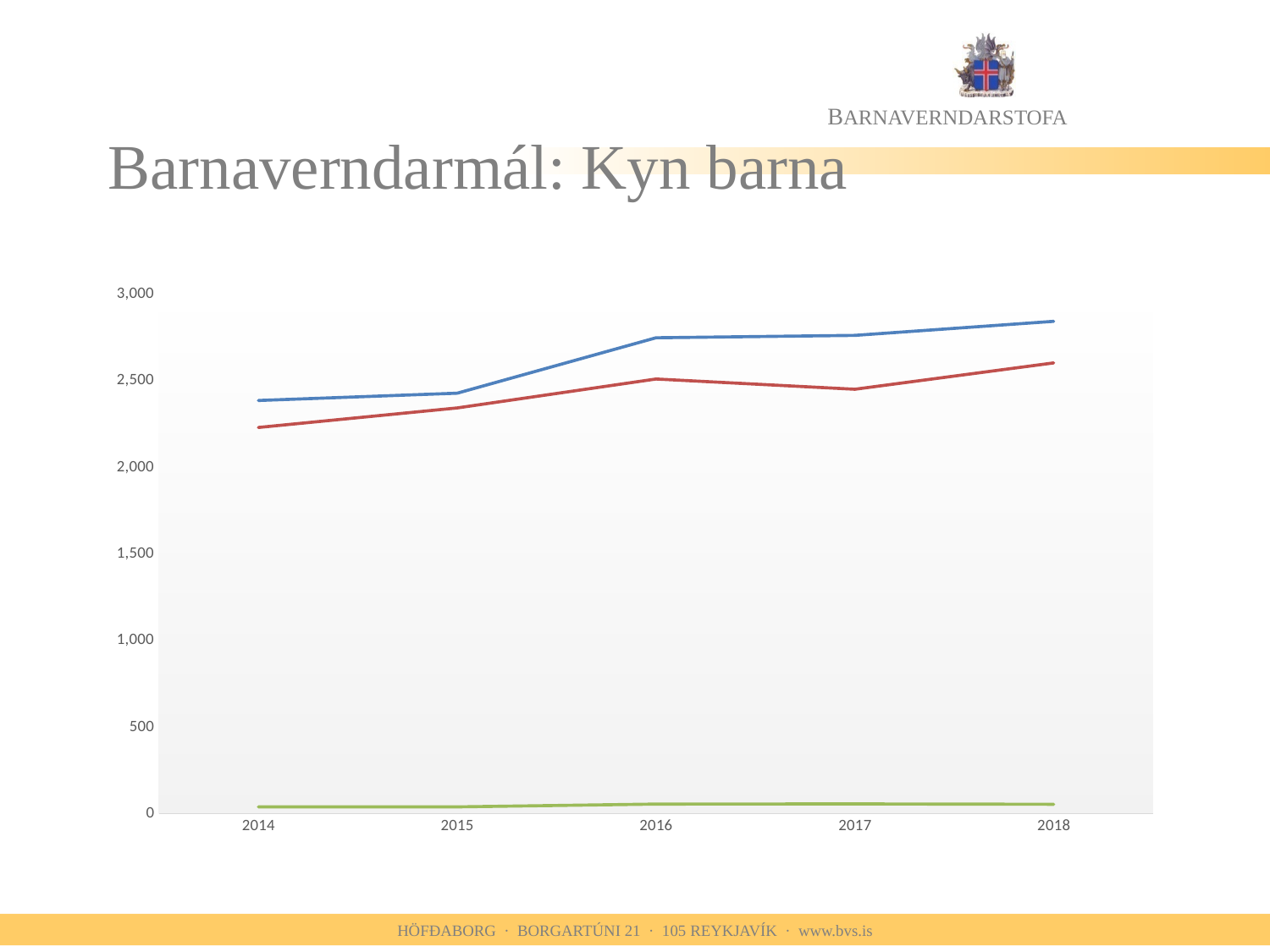
Is the value of the blue line in 2018 greater or less than 2,500? greater In which year does the red line have its lowest value? 2014 What kind of chart is shown on the slide? line chart In which year does the blue line reach its highest value? 2018 How many lines are plotted on the chart? 3 Is the value of the red line in 2014 greater or less than 2,500? less Is the value of the blue line in 2014 greater or less than 2,500? less In 2017, which line has the higher value, the blue line or the red line? the blue line How many years are shown on the x axis of the chart? 5 Does the blue line generally rise or fall from 2014 to 2018? rise What is the title of the slide containing the chart? Barnaverndarmál: Kyn barna